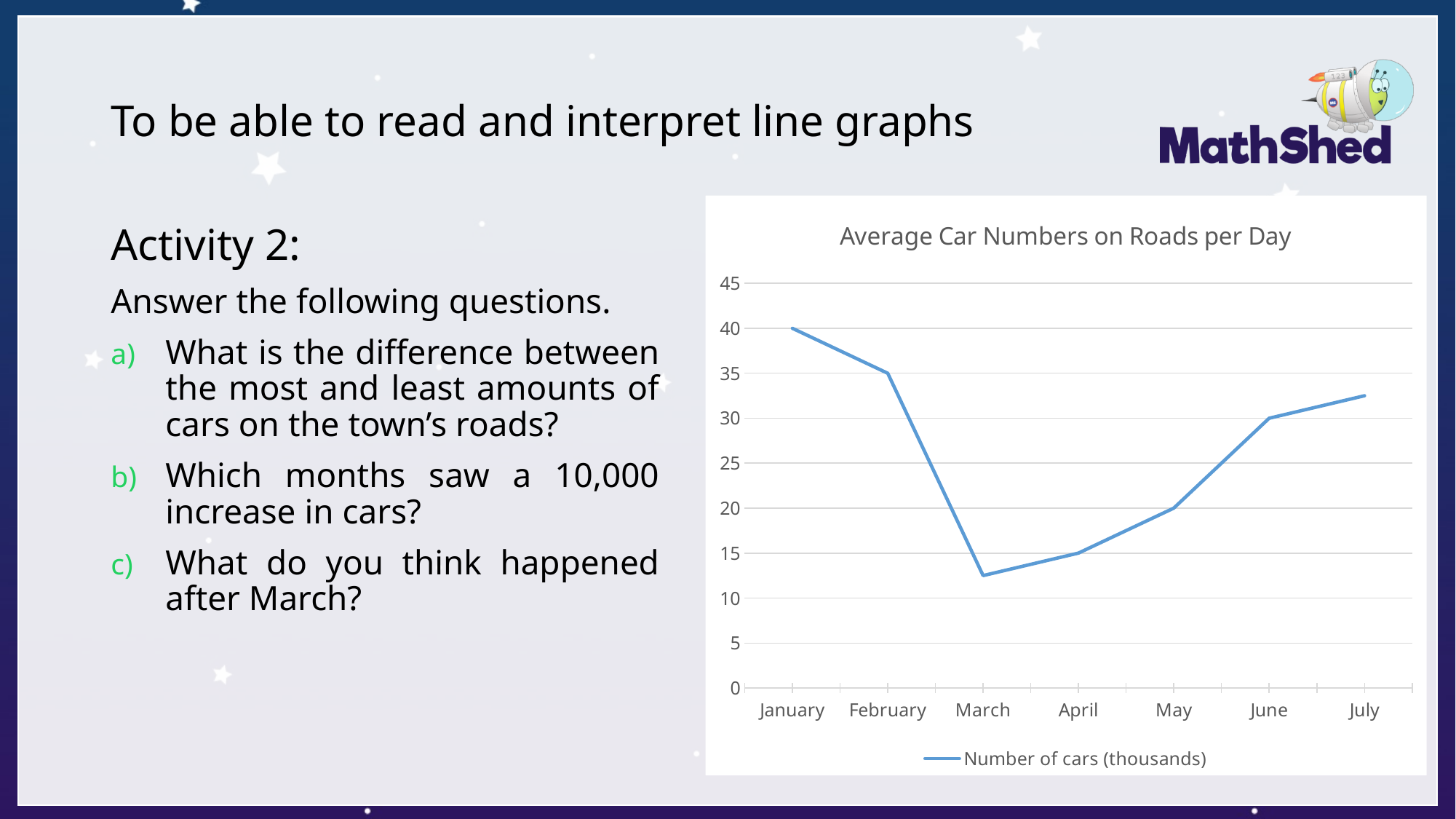
How many series does the chart's legend list? 1 Which month has the lowest value? March What is the value for June? 30 What is the value for January? 40 Which month has the highest value? January Is the value for March greater or less than 15? less What kind of chart is shown on the slide? line chart What is the value for February? 35 What is the title of the chart? Average Car Numbers on Roads per Day How many months are plotted on the x axis of the chart? 7 What is the value for May? 20 What is the difference between the values for January and February? 5